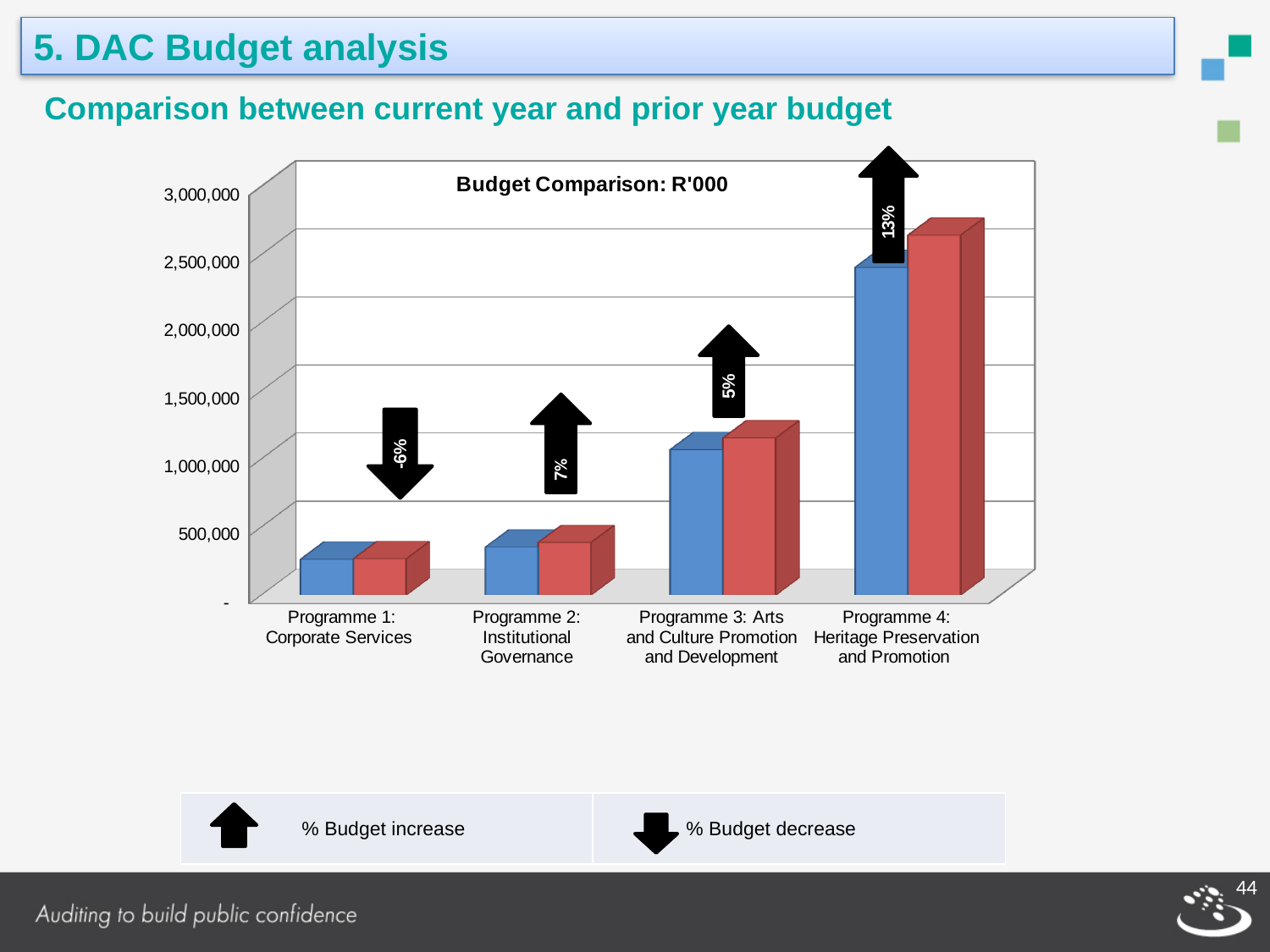
What percentage budget change is shown for Programme 4: Heritage Preservation and Promotion? 13% What is the title of the chart? Budget Comparison: R'000 Which programme has the smallest budget in the chart? Programme 1: Corporate Services What kind of chart is shown on the slide? Bar chart Are the bars for Programme 4: Heritage Preservation and Promotion greater or less than 2,000,000? greater Which programme shows a budget decrease according to the arrows? Programme 1: Corporate Services What percentage budget change is shown for Programme 2: Institutional Governance? 7% What percentage budget change is shown for Programme 1: Corporate Services? -6% Are the bars for Programme 1: Corporate Services greater or less than 500,000? less Which programme has the largest budget in the chart? Programme 4: Heritage Preservation and Promotion How many programmes are shown on the x axis of the chart? 4 What percentage budget change is shown for Programme 3: Arts and Culture Promotion and Development? 5%